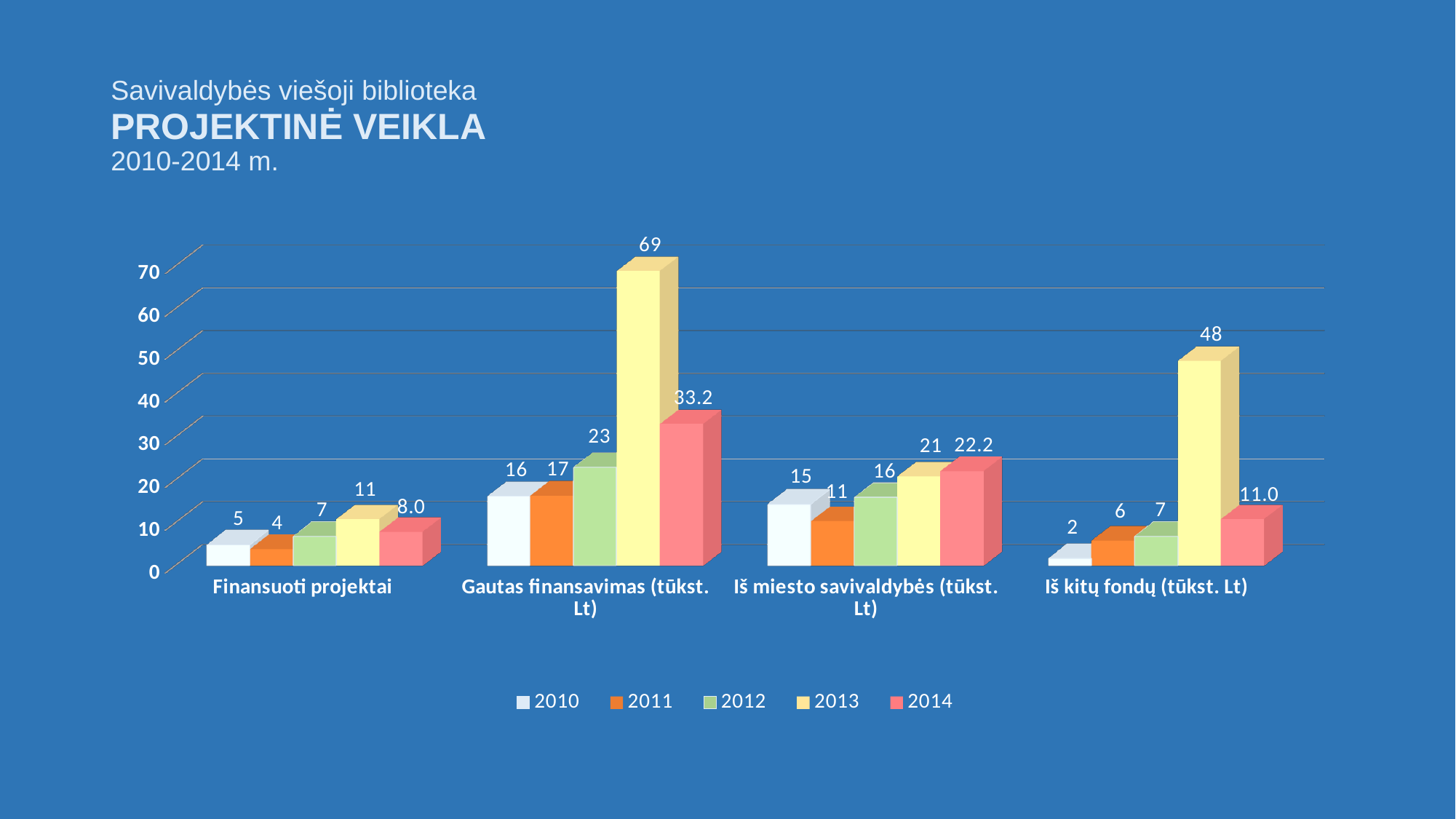
How many series does the legend list? 5 What is the value for 2010 in the "Iš miesto savivaldybės (tūkst. Lt)" category? 15 What kind of chart is shown on the slide? Bar chart Which is larger in the "Iš miesto savivaldybės (tūkst. Lt)" category: the 2010 value or the 2011 value? 2010 What is the value for 2014 in the "Finansuoti projektai" category? 8.0 What is the difference between the 2013 and 2012 values in the "Gautas finansavimas (tūkst. Lt)" category? 46 Which colour represents the 2013 series in the legend? Yellow Which year has the highest value in the "Gautas finansavimas (tūkst. Lt)" category? 2013 Which year has the lowest value in the "Iš kitų fondų (tūkst. Lt)" category? 2010 What is the value for 2013 in the "Iš kitų fondų (tūkst. Lt)" category? 48 What is the value for 2013 in the "Gautas finansavimas (tūkst. Lt)" category? 69 How many categories are shown on the x axis? 4